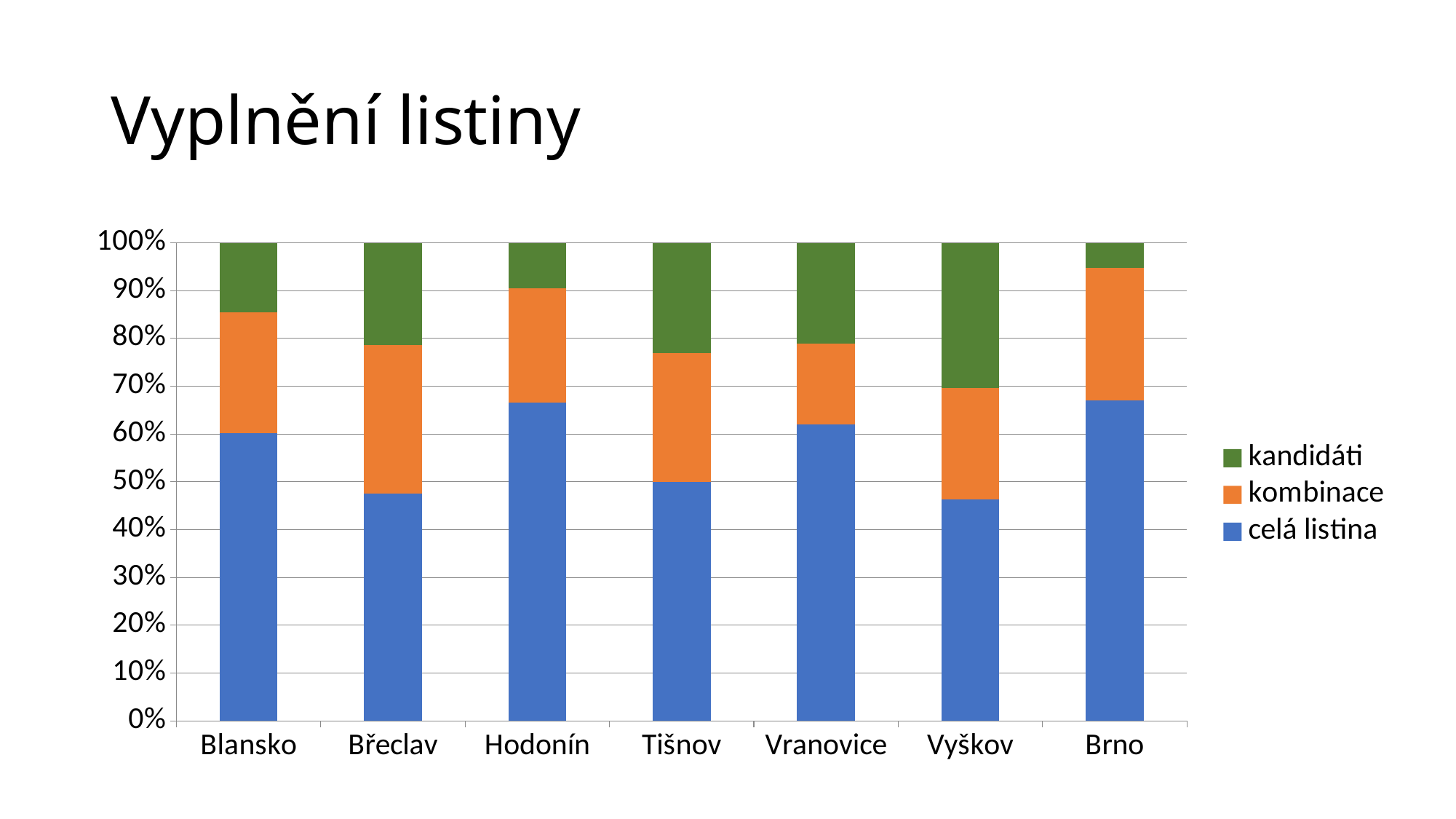
Which colour represents the 'kandidáti' series in the legend? green Which has a larger 'celá listina' segment, Hodonín or Tišnov? Hodonín Which category has the smallest 'kandidáti' segment? Brno Which category has the largest 'kandidáti' segment? Vyškov What is the total height of the stacked bar for Blansko? 100% How many series does the legend list? 3 What is the title of the chart? Vyplnění listiny Is the 'celá listina' value for Hodonín greater or less than 60%? greater Is the 'celá listina' value for Vyškov greater or less than 50%? less What kind of chart is shown on the slide? stacked bar chart How many categories are shown on the x axis? 7 Which category has the smallest 'kombinace' segment? Vranovice